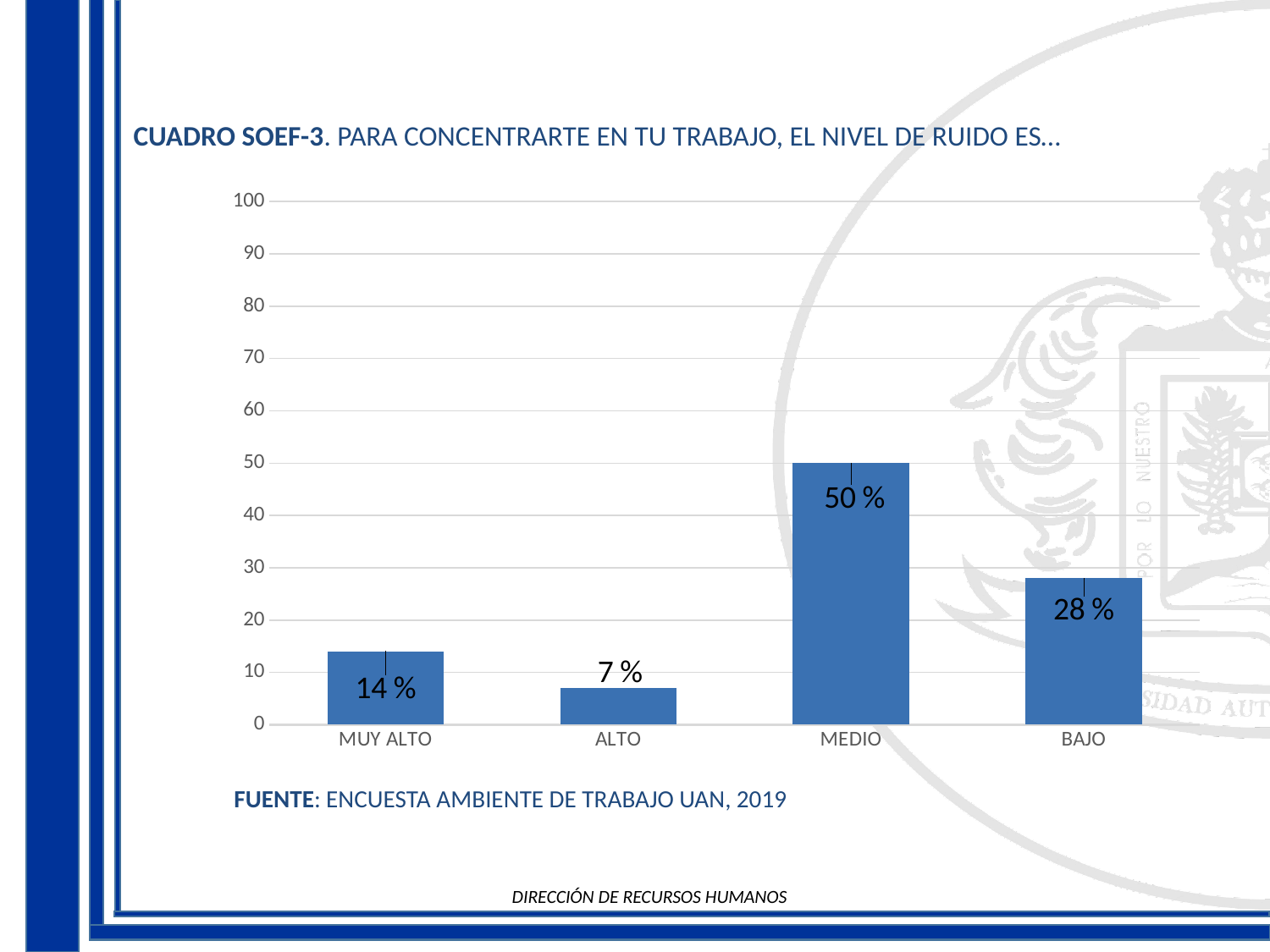
What is the difference between the values for MEDIO and BAJO? 22 % What is the value for BAJO? 28 % How many categories are shown on the x axis? 4 What is the value for MEDIO? 50 % What is the value for MUY ALTO? 14 % Is the value for BAJO greater or less than 30? less What is the value for ALTO? 7 % Which is larger, the value for MUY ALTO or the value for ALTO? MUY ALTO Which category has the lowest value? ALTO Which category has the highest value? MEDIO What source is cited below the chart? ENCUESTA AMBIENTE DE TRABAJO UAN, 2019 What kind of chart is shown on the slide? bar chart